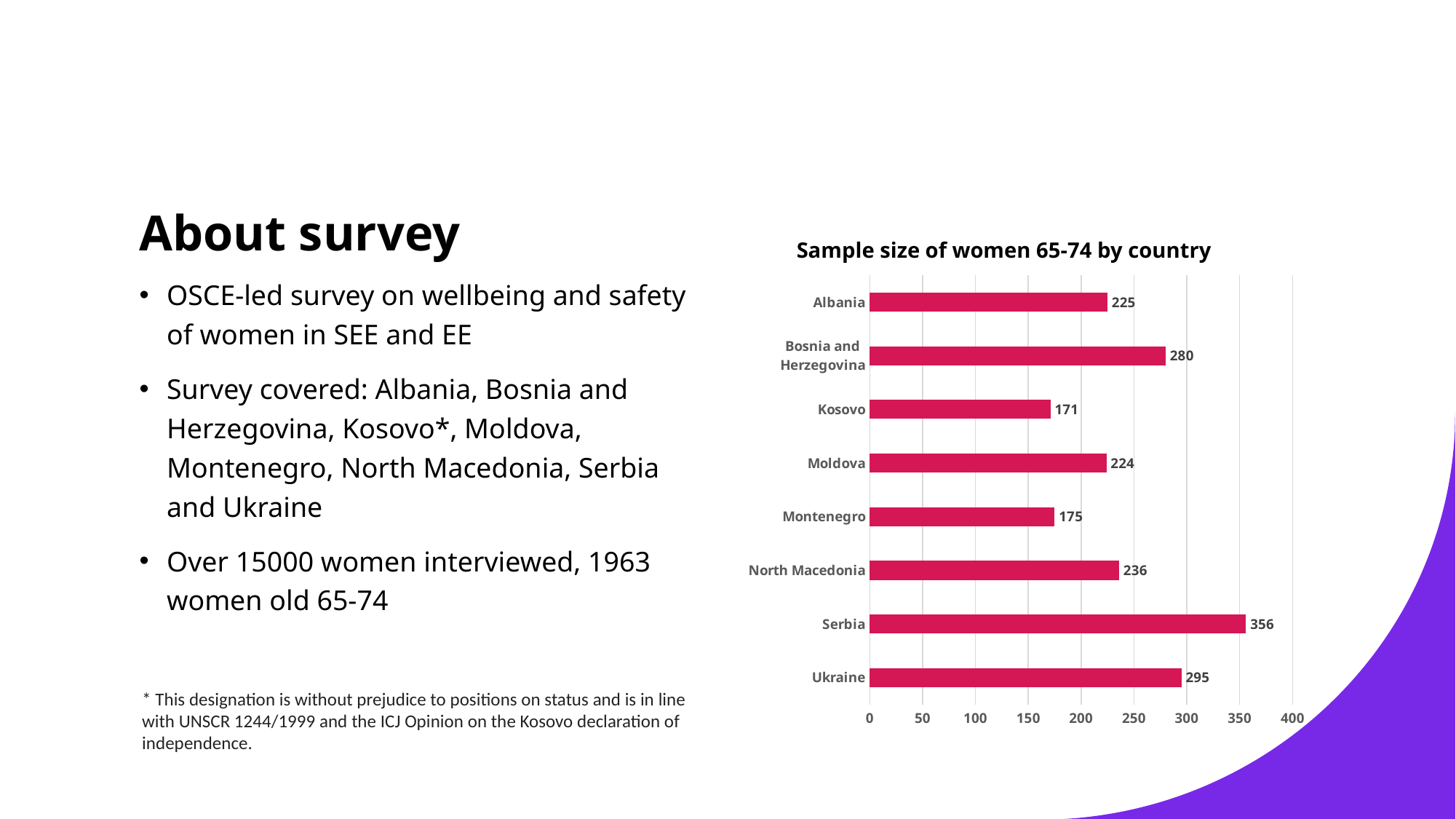
Which has a larger sample size, North Macedonia or Moldova? North Macedonia How many countries are shown in the chart? 8 What is the sample size of women 65-74 for Bosnia and Herzegovina? 280 What kind of chart is shown on the slide? Bar chart What is the sample size of women 65-74 for Serbia? 356 Which country has the largest sample size of women 65-74? Serbia What is the difference between the sample sizes for Albania and Moldova? 1 What is the difference between the sample sizes for Ukraine and Montenegro? 120 Is the value for Ukraine greater or less than 250? greater What is the title of the chart? Sample size of women 65-74 by country What is the sample size of women 65-74 for Kosovo? 171 Which country has the smallest sample size of women 65-74? Kosovo